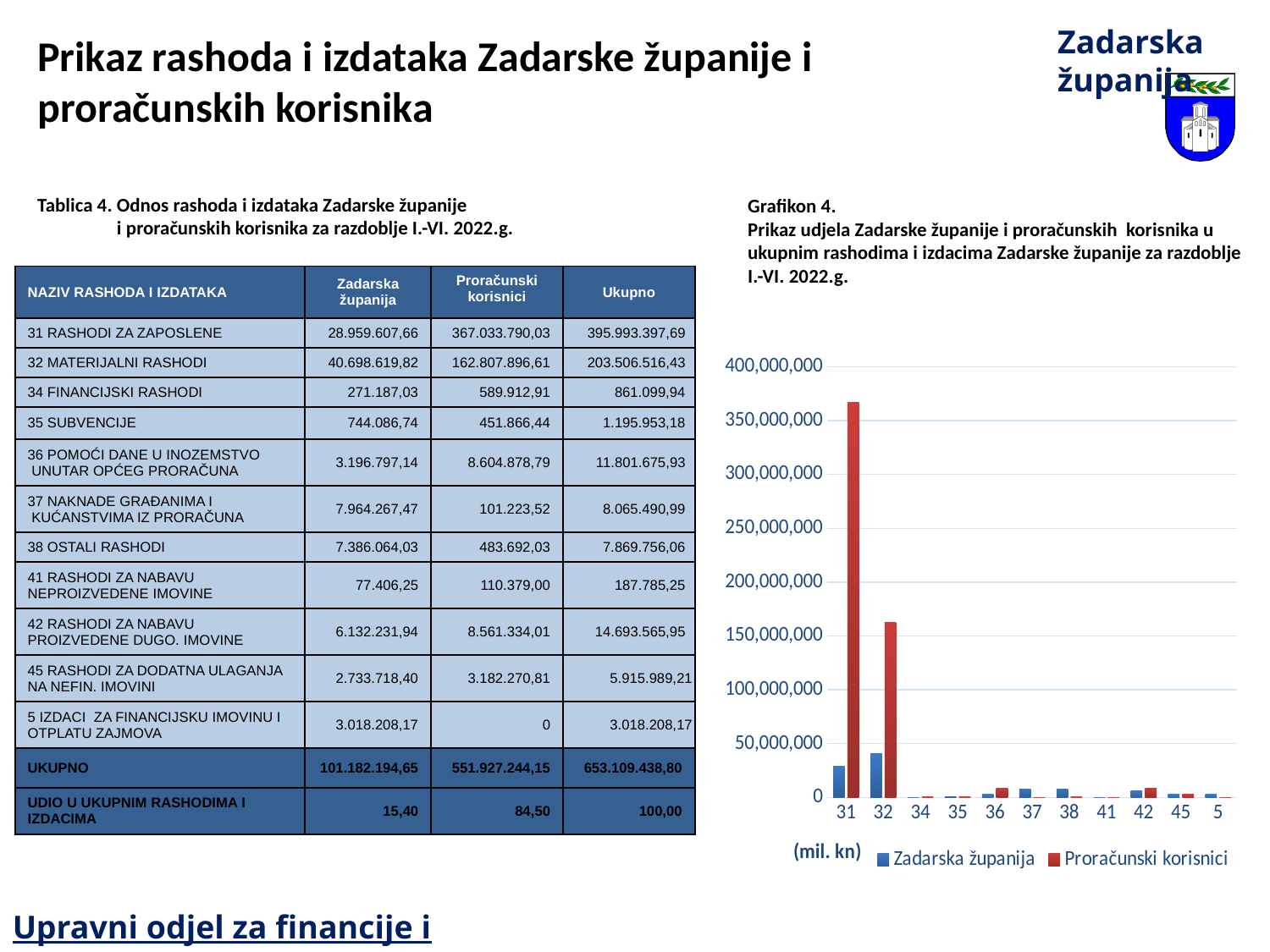
In Grafikon 4, is the Proračunski korisnici value for category 32 greater or less than 150,000,000? greater What unit label is shown below the x axis of Grafikon 4? (mil. kn) In Grafikon 4, which colour represents the Zadarska županija series? blue In Grafikon 4, which category has the highest value for Zadarska županija? 32 In Grafikon 4, which category has the highest value for Proračunski korisnici? 31 In Grafikon 4, is the Proračunski korisnici value for category 31 greater or less than 350,000,000? greater How many categories are shown on the x axis of Grafikon 4? 11 In Grafikon 4, is the Zadarska županija value for category 31 greater or less than 50,000,000? less How many series does the legend of Grafikon 4 list? 2 What kind of chart is Grafikon 4? bar chart In Grafikon 4, for category 31, which series has the larger value: Zadarska županija or Proračunski korisnici? Proračunski korisnici